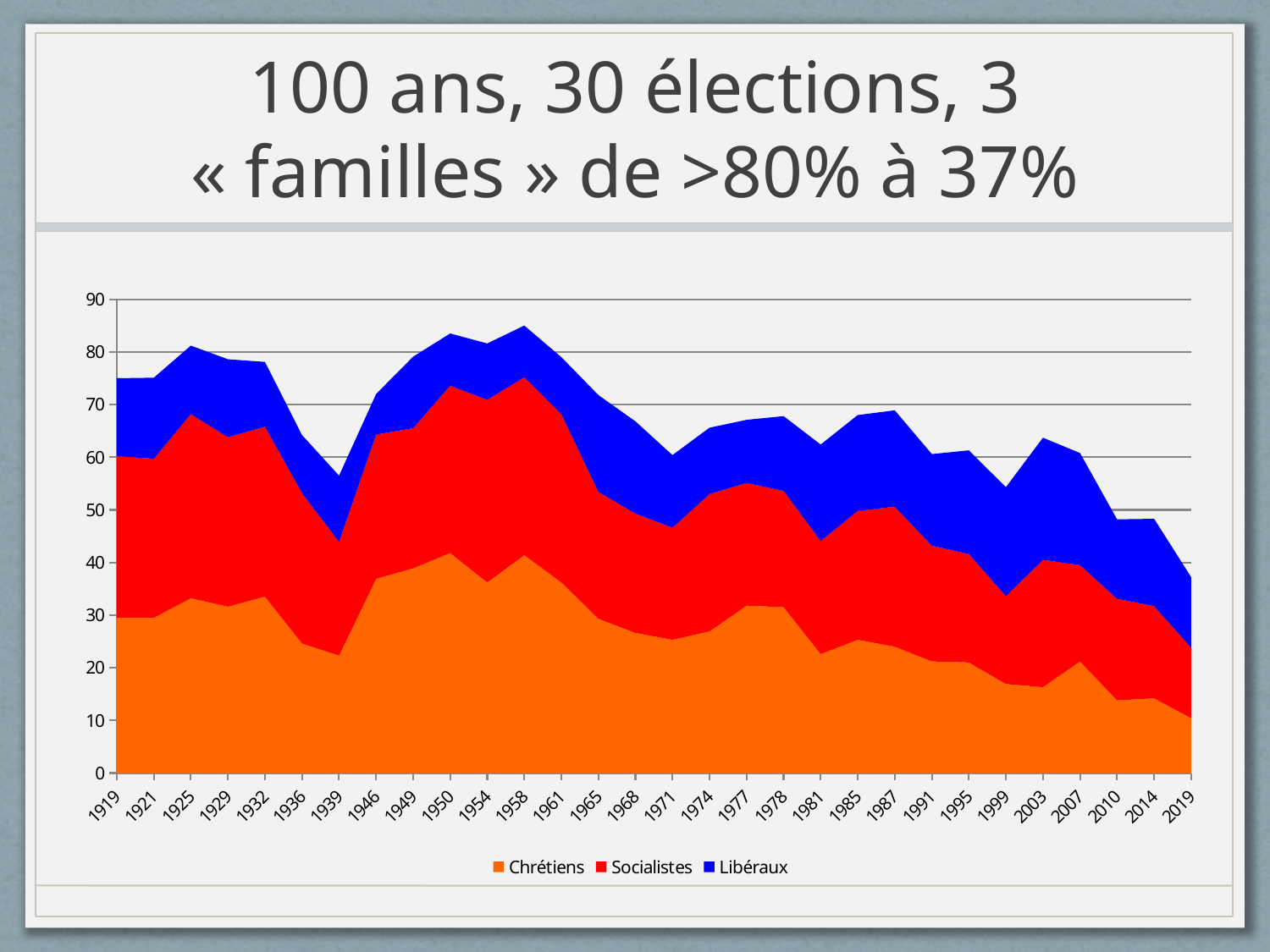
What kind of chart is shown on the slide? Stacked area chart Does the combined total of the three families rise or fall overall from 1919 to 2019? fall Is the combined total of the three families in 1939 greater or less than 60? less Which colour represents Libéraux in the chart? Blue Is the combined total of the three families in 1958 greater or less than 80? greater How many election years are shown along the x axis? 30 Is the combined total of the three families in 2019 greater or less than 40? less Which year has the lowest combined total of the three families? 2019 Which series is shown in orange? Chrétiens How many series does the legend list? 3